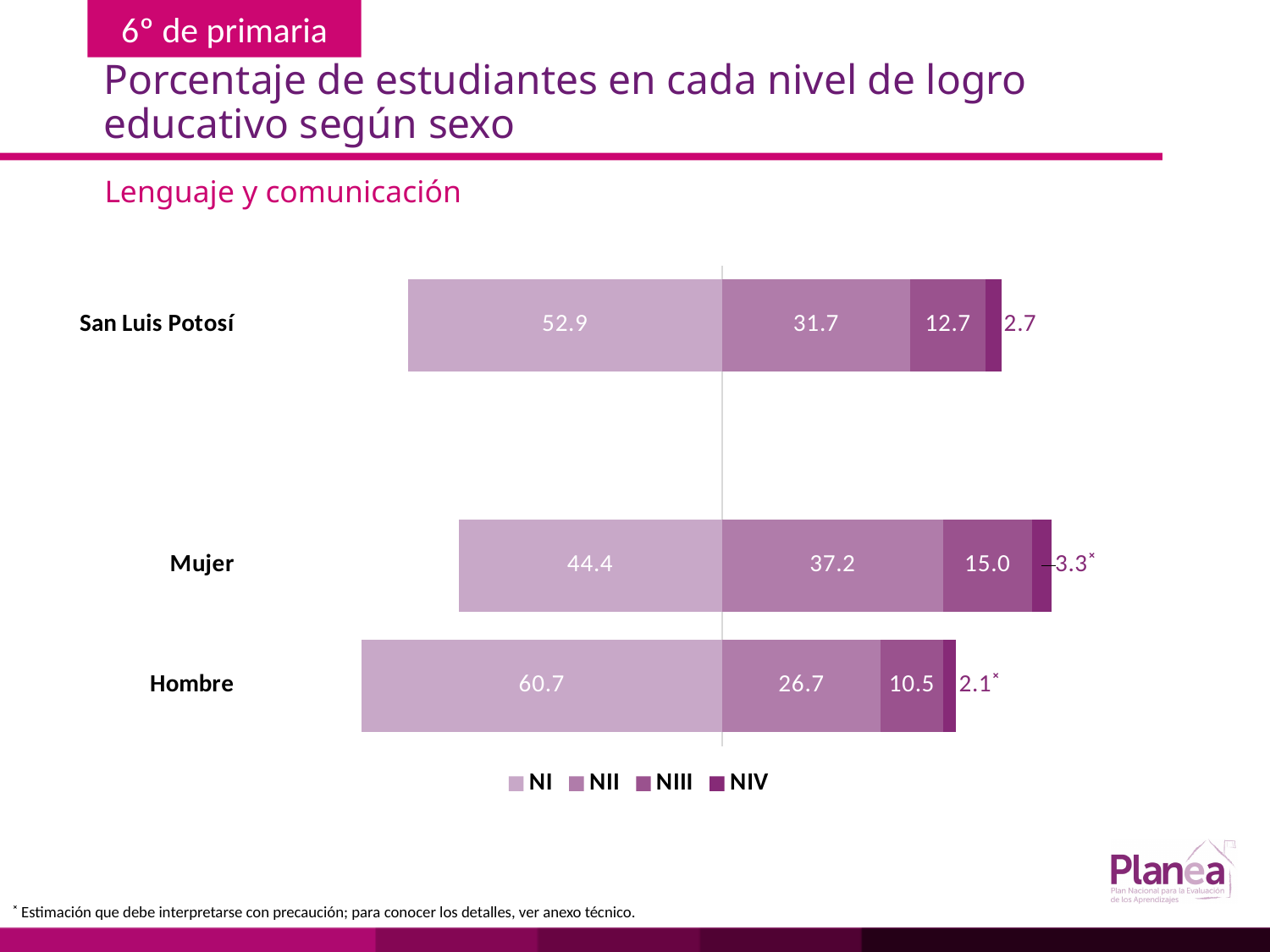
How many categories are shown on the chart? 3 What is the NII value for Mujer? 37.2 Which is larger, the NII value for San Luis Potosí or the NII value for Mujer? Mujer Which category has the highest NI value? Hombre What is the total of the stacked bar for San Luis Potosí? 100.0 What is the NIII value for San Luis Potosí? 12.7 What is the NI value for Hombre? 60.7 What is the NIV value for Hombre? 2.1 How many series does the legend list? 4 What is the difference between the NI values for Hombre and Mujer? 16.3 What kind of chart is shown on the slide? Stacked bar chart Which category has the lowest NIII value? Hombre